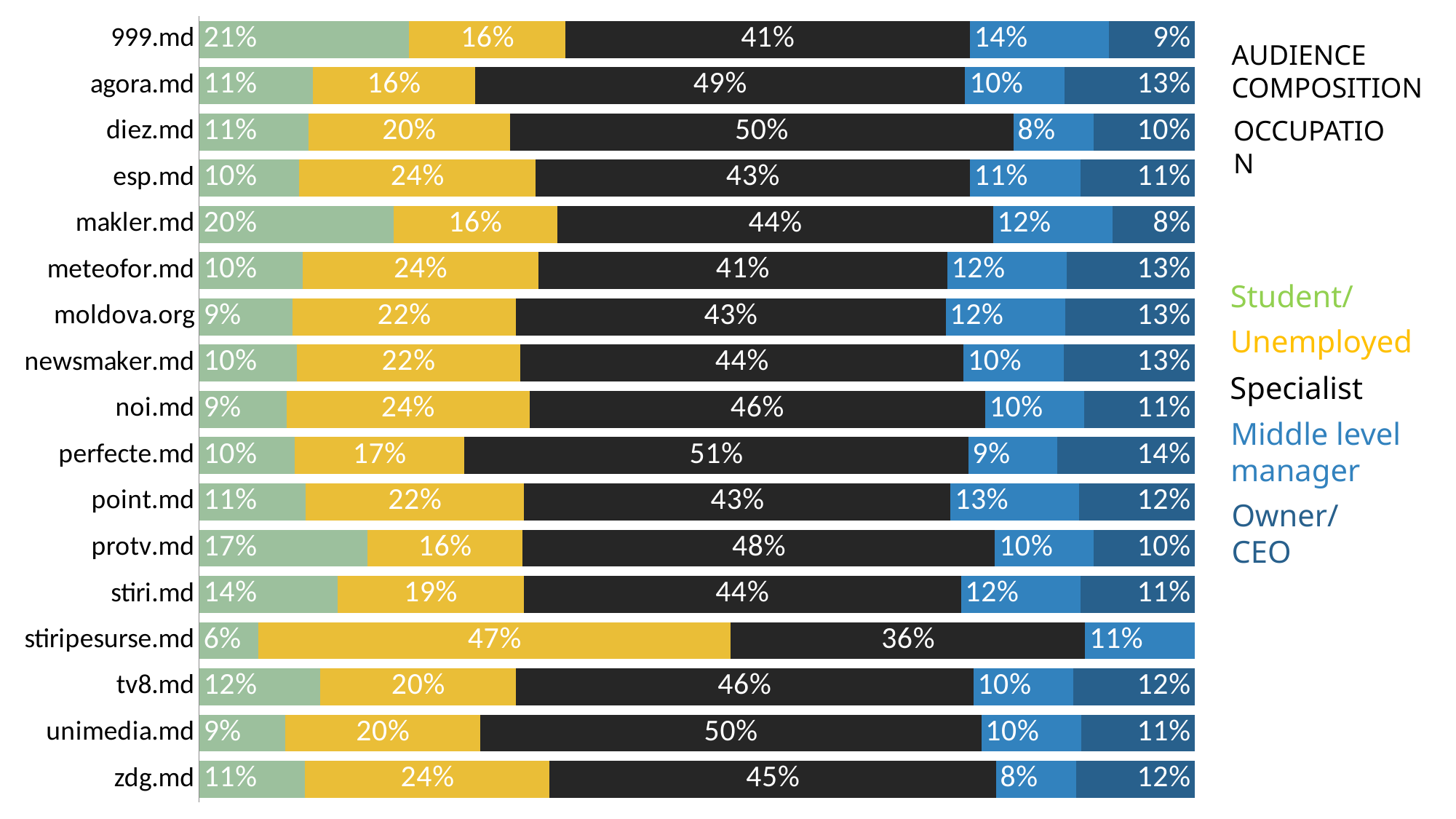
Which website has the highest Specialist share? perfecte.md What is the difference between the Specialist share of agora.md and that of 999.md? 8 percentage points Which website has the lowest Student/ share? stiripesurse.md What is the Unemployed share for stiripesurse.md? 47% What kind of chart is shown on the slide? Stacked bar chart How many series does the legend list? 5 What colour represents the Specialist series? Black What is the Specialist share for perfecte.md? 51% What is the Owner/CEO share for makler.md? 8% What is the total of the labelled segments for stiripesurse.md? 100% Which has the larger Student/ share, 999.md or protv.md? 999.md How many websites are listed on the chart? 17